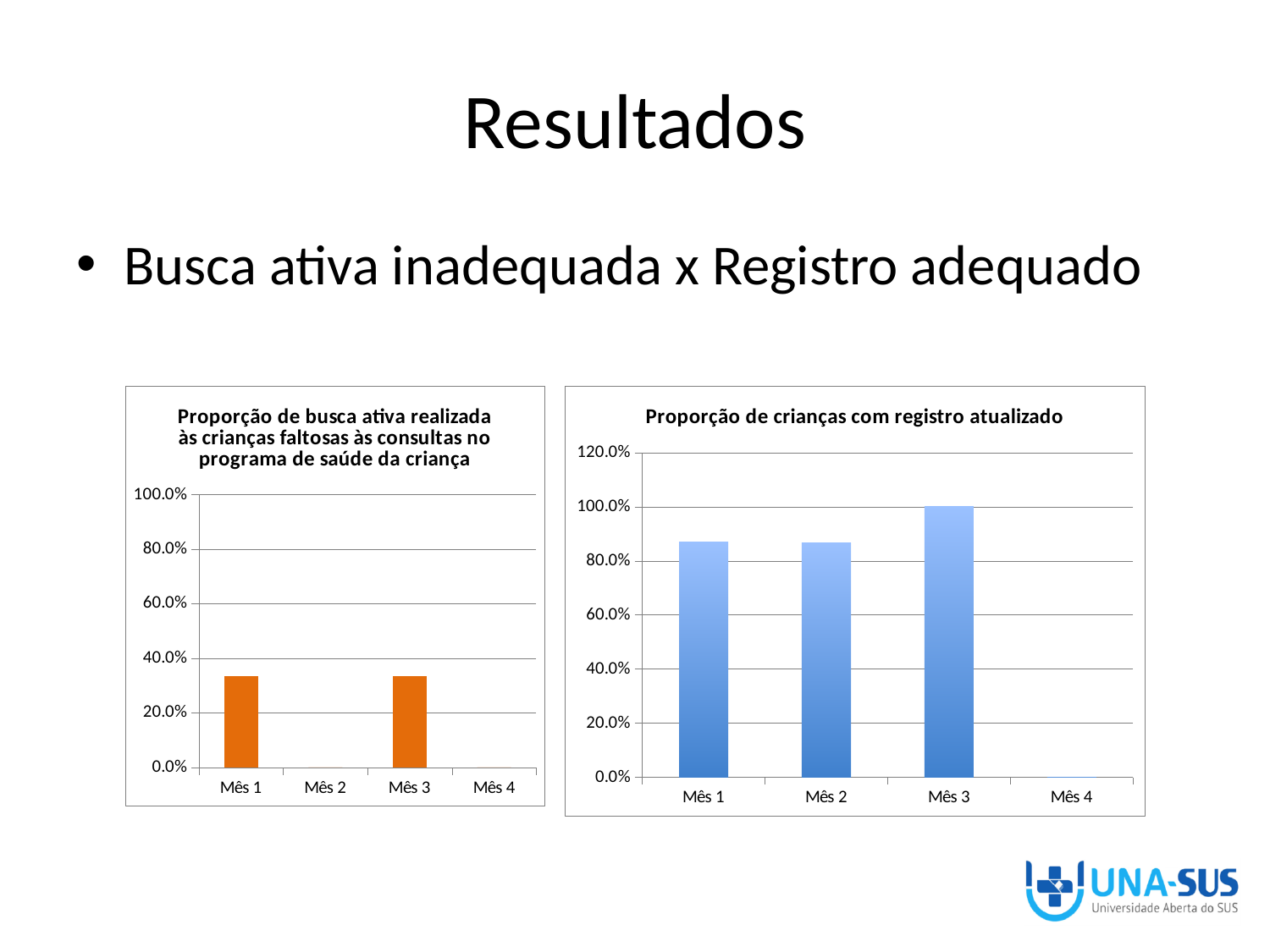
In the right chart, 'Proporção de crianças com registro atualizado', which month has the highest value? Mês 3 What kind of chart is the left chart, 'Proporção de busca ativa realizada às crianças faltosas às consultas no programa de saúde da criança'? bar chart In the right chart, 'Proporção de crianças com registro atualizado', what is the value for Mês 3? 100.0% In the right chart, 'Proporção de crianças com registro atualizado', which is larger, the value for Mês 2 or Mês 3? Mês 3 In the right chart, 'Proporção de crianças com registro atualizado', which month has the lowest value? Mês 4 In the left chart, 'Proporção de busca ativa realizada...', is the value for Mês 3 greater or less than 20.0%? greater What colour are the bars in the left chart? orange In the right chart, 'Proporção de crianças com registro atualizado', is the value for Mês 1 greater or less than 80.0%? greater In the left chart, 'Proporção de busca ativa realizada...', is the value for Mês 1 greater or less than 40.0%? less What is the title of the right chart? Proporção de crianças com registro atualizado In the right chart, 'Proporção de crianças com registro atualizado', how many categories are shown on the x axis? 4 In the right chart, 'Proporção de crianças com registro atualizado', what is the value for Mês 4? 0.0%